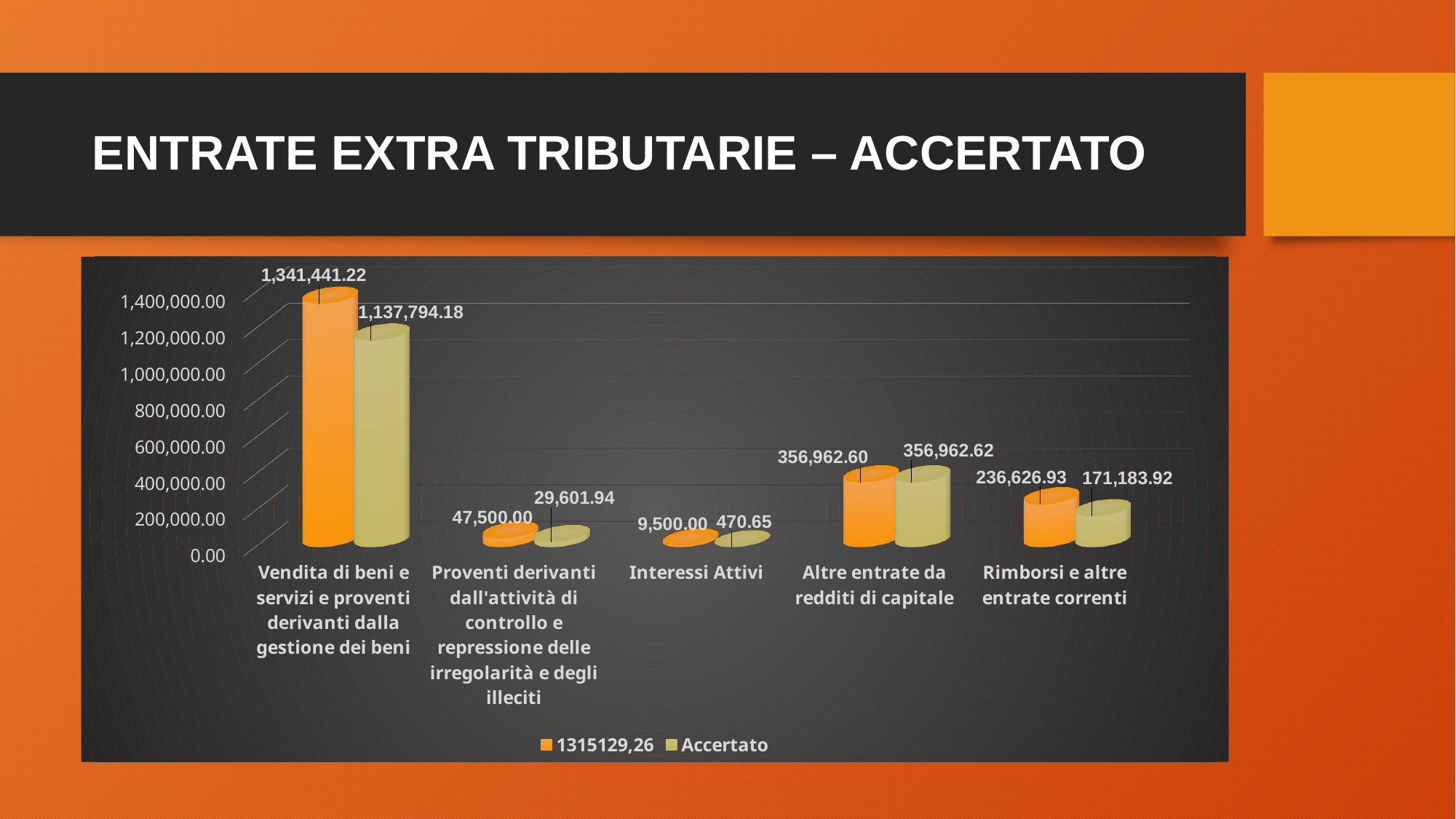
What kind of chart is shown on the slide? Bar chart What is the difference between the 1315129,26 value and the Accertato value for Interessi Attivi? 9,029.35 How many series does the legend list? 2 What is the Accertato value for Interessi Attivi? 470.65 How many categories are shown on the x axis? 5 Which category has the lowest Accertato value? Interessi Attivi What is the Accertato value for Vendita di beni e servizi e proventi derivanti dalla gestione dei beni? 1,137,794.18 For Proventi derivanti dall'attività di controllo e repressione delle irregolarità e degli illeciti, which is larger: the 1315129,26 value or the Accertato value? 1315129,26 What is the difference between the 1315129,26 value and the Accertato value for Rimborsi e altre entrate correnti? 65,443.01 What is the value of the 1315129,26 series for Rimborsi e altre entrate correnti? 236,626.93 What is the value of the 1315129,26 series for Proventi derivanti dall'attività di controllo e repressione delle irregolarità e degli illeciti? 47,500.00 Which category has the highest Accertato value? Vendita di beni e servizi e proventi derivanti dalla gestione dei beni